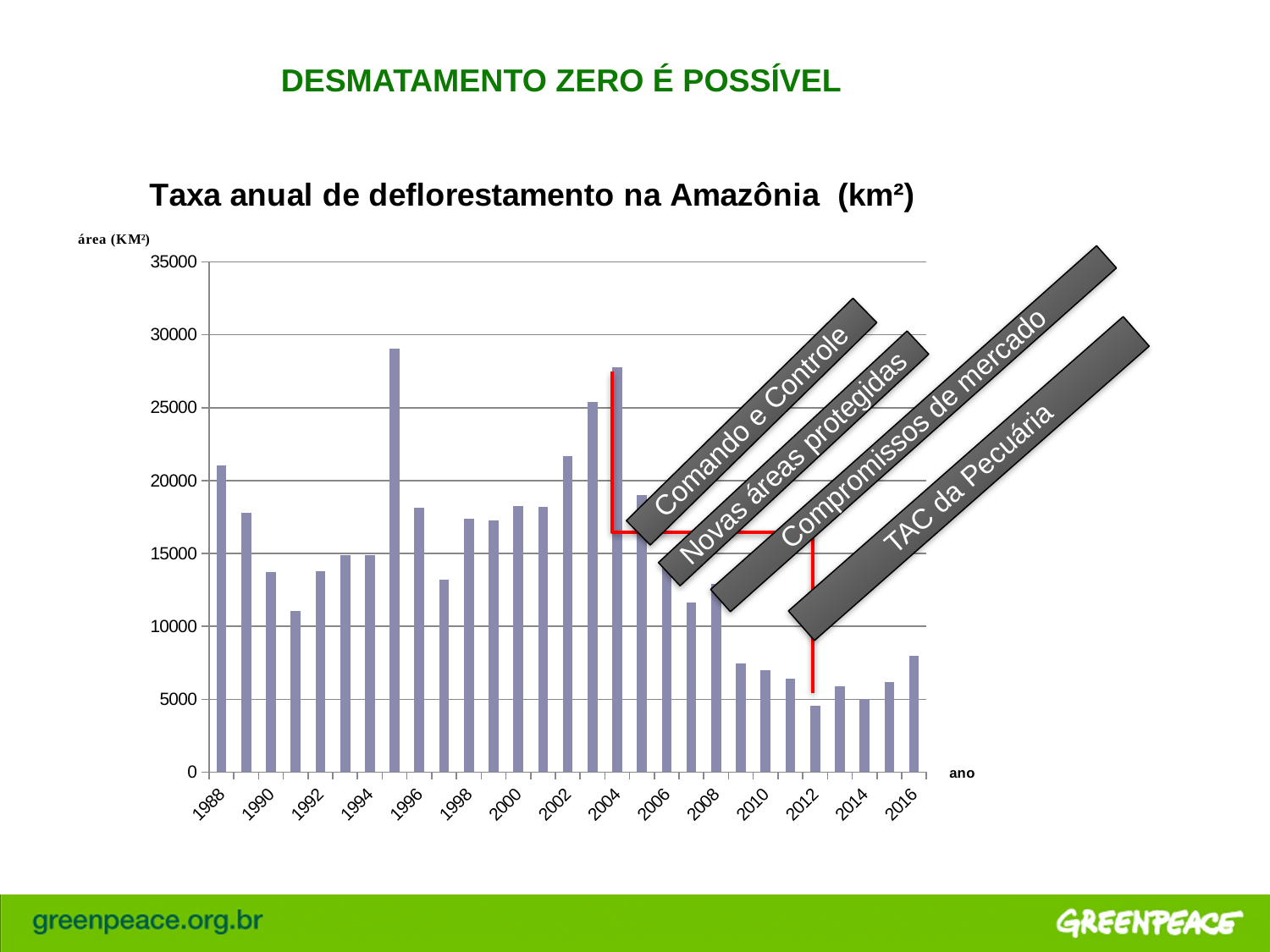
What is the label on the vertical axis of the chart? área (KM²) Is the value for 2004 greater or less than 25000? greater Which year has the highest deforestation rate in the chart? 1995 Is the value for 2012 greater or less than 5000? less What kind of chart is shown on the slide? bar chart What is the title of the chart? Taxa anual de deflorestamento na Amazônia (km²) Which year has the lowest deforestation rate in the chart? 2012 Is the value for 1995 greater or less than 25000? greater Which year has a larger value, 2004 or 2008? 2004 Which year has a larger value, 1988 or 1990? 1988 Do the values generally rise or fall from 2004 to 2012? fall